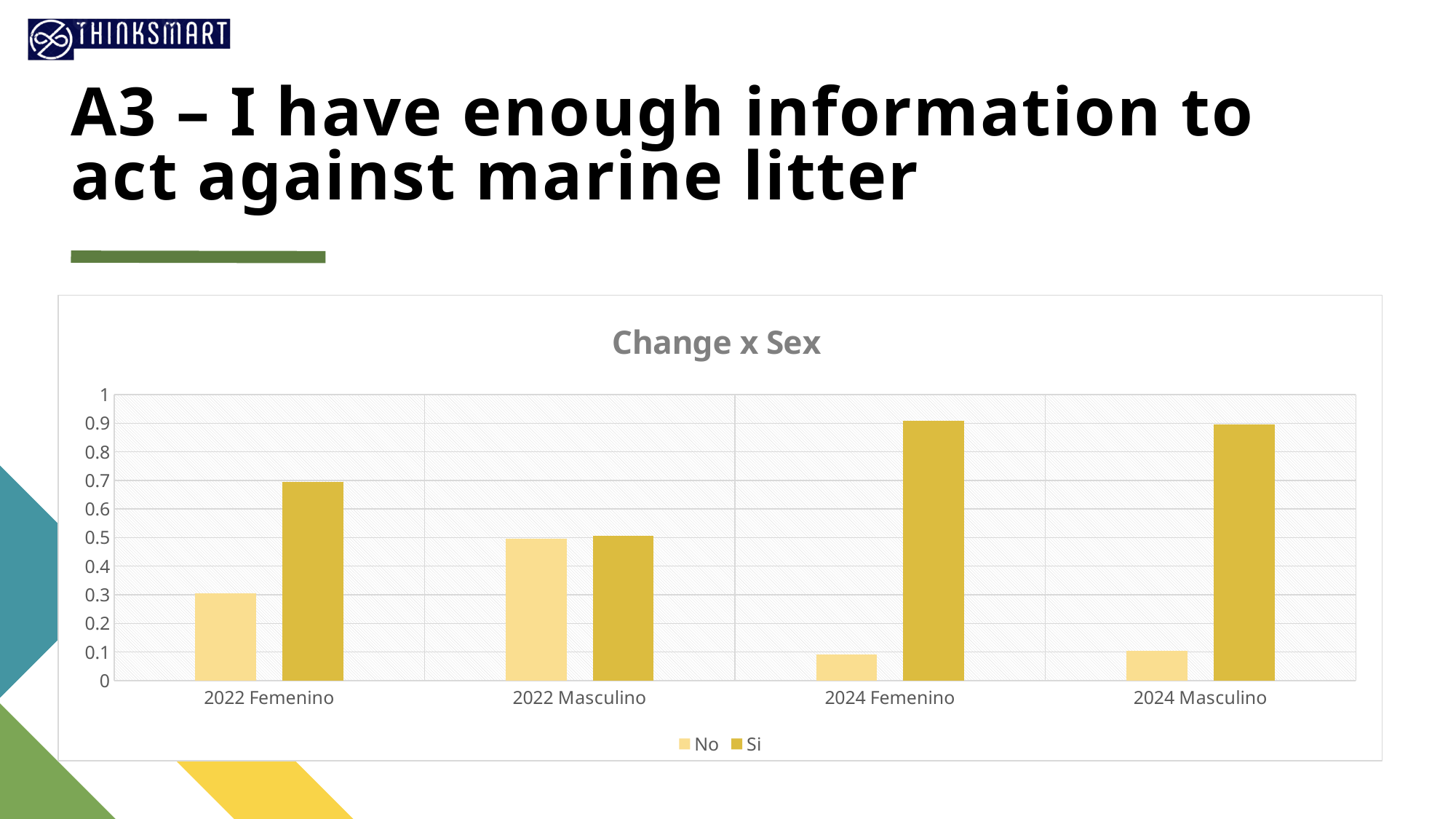
What is the title of the chart? Change x Sex Which category has the lowest value for the Si series? 2022 Masculino Which is larger, the No value for 2022 Femenino or the No value for 2024 Femenino? 2022 Femenino Is the Si value for 2022 Femenino greater or less than 0.6? greater How many series does the legend list? 2 Which category has the highest value for the No series? 2022 Masculino Is the No value for 2024 Masculino greater or less than 0.2? less What kind of chart is shown on the slide? bar chart How many categories are shown on the x axis? 4 Is the No value for 2022 Femenino greater or less than 0.4? less For 2024 Femenino, which is larger, the No value or the Si value? Si